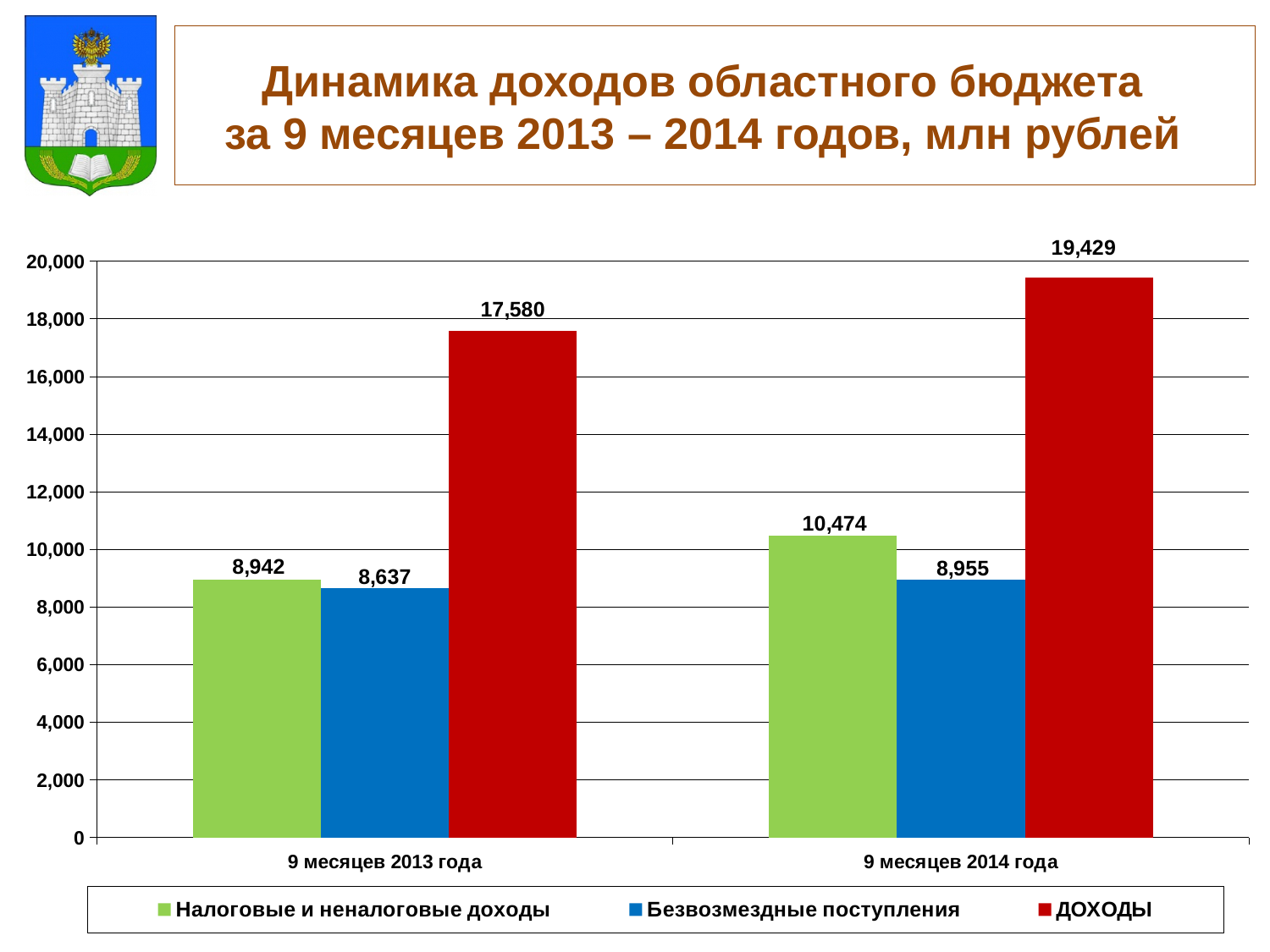
What is the value of ДОХОДЫ for 9 месяцев 2014 года? 19,429 Which is larger: Налоговые и неналоговые доходы for 9 месяцев 2014 года or Безвозмездные поступления for 9 месяцев 2014 года? Налоговые и неналоговые доходы for 9 месяцев 2014 года Which series has the highest value for 9 месяцев 2013 года? ДОХОДЫ Does the value of ДОХОДЫ rise or fall from 9 месяцев 2013 года to 9 месяцев 2014 года? Rise What is the value of Налоговые и неналоговые доходы for 9 месяцев 2013 года? 8,942 What is the difference between ДОХОДЫ for 9 месяцев 2014 года and 9 месяцев 2013 года? 1,849 How many categories are shown on the x axis? 2 Which series has the lowest value for 9 месяцев 2014 года? Безвозмездные поступления What is the value of Безвозмездные поступления for 9 месяцев 2014 года? 8,955 What kind of chart is shown on the slide? Bar chart What is the difference between Налоговые и неналоговые доходы and Безвозмездные поступления for 9 месяцев 2013 года? 305 How many series does the legend list? 3